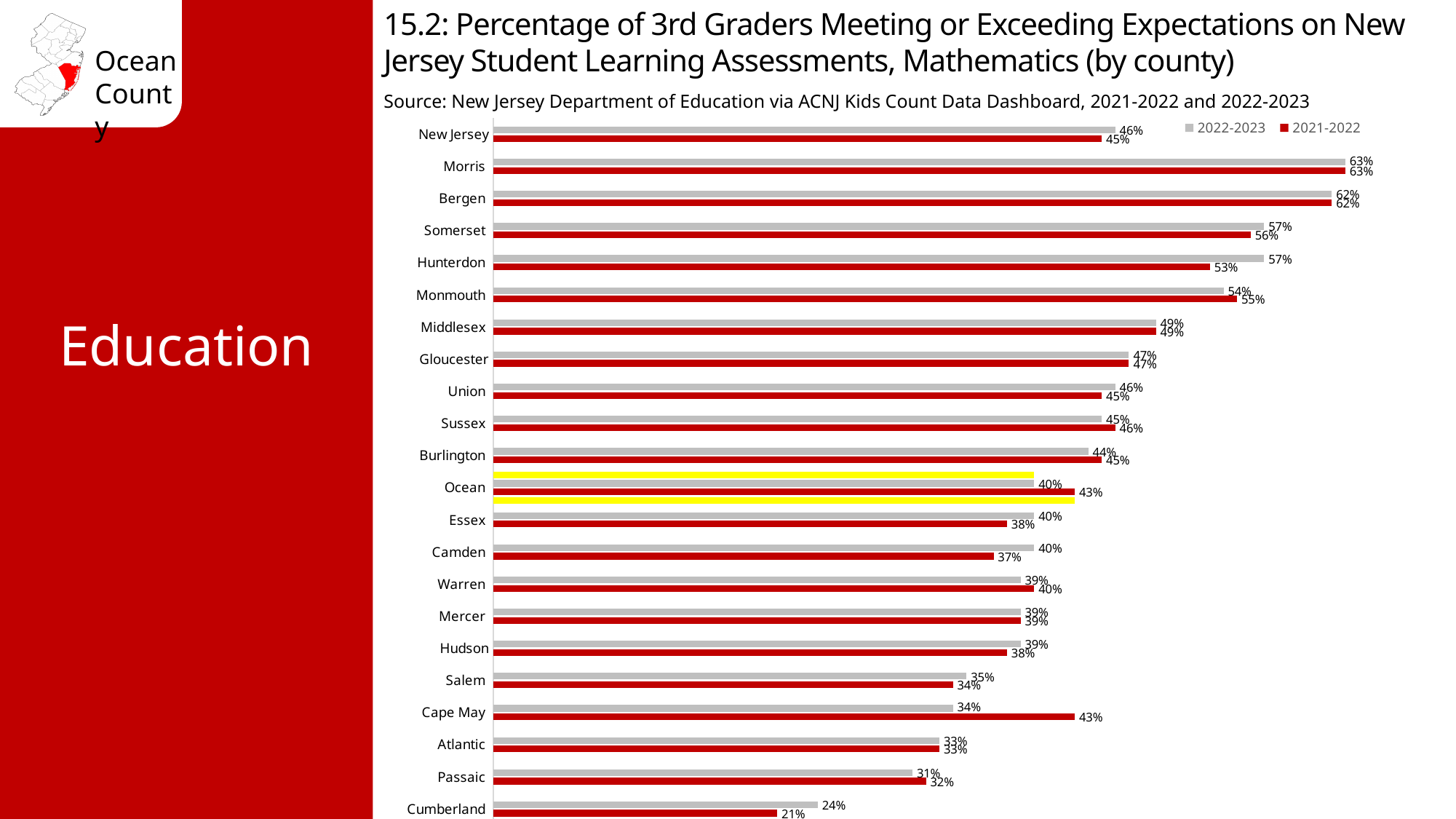
Which was higher for Cape May: the 2021-2022 value or the 2022-2023 value? 2021-2022 Which county had the highest percentage in 2022-2023? Morris What was the 2021-2022 value for Cape May? 43% By how many percentage points did Ocean County's value change from 2021-2022 to 2022-2023? 3 percentage points (43% to 40%) How many series does the legend list? 2 How many counties (including the New Jersey statewide row) are listed on the chart? 22 Which county had the lowest percentage in 2021-2022? Cumberland What was the 2022-2023 value for Hunterdon? 57% What percentage of Ocean County 3rd graders met or exceeded expectations in mathematics in 2022-2023? 40% Which colour represents the 2021-2022 series in the legend? Red What type of chart is shown on the slide? Bar chart What is the difference between Hunterdon's 2022-2023 and 2021-2022 values? 4 percentage points